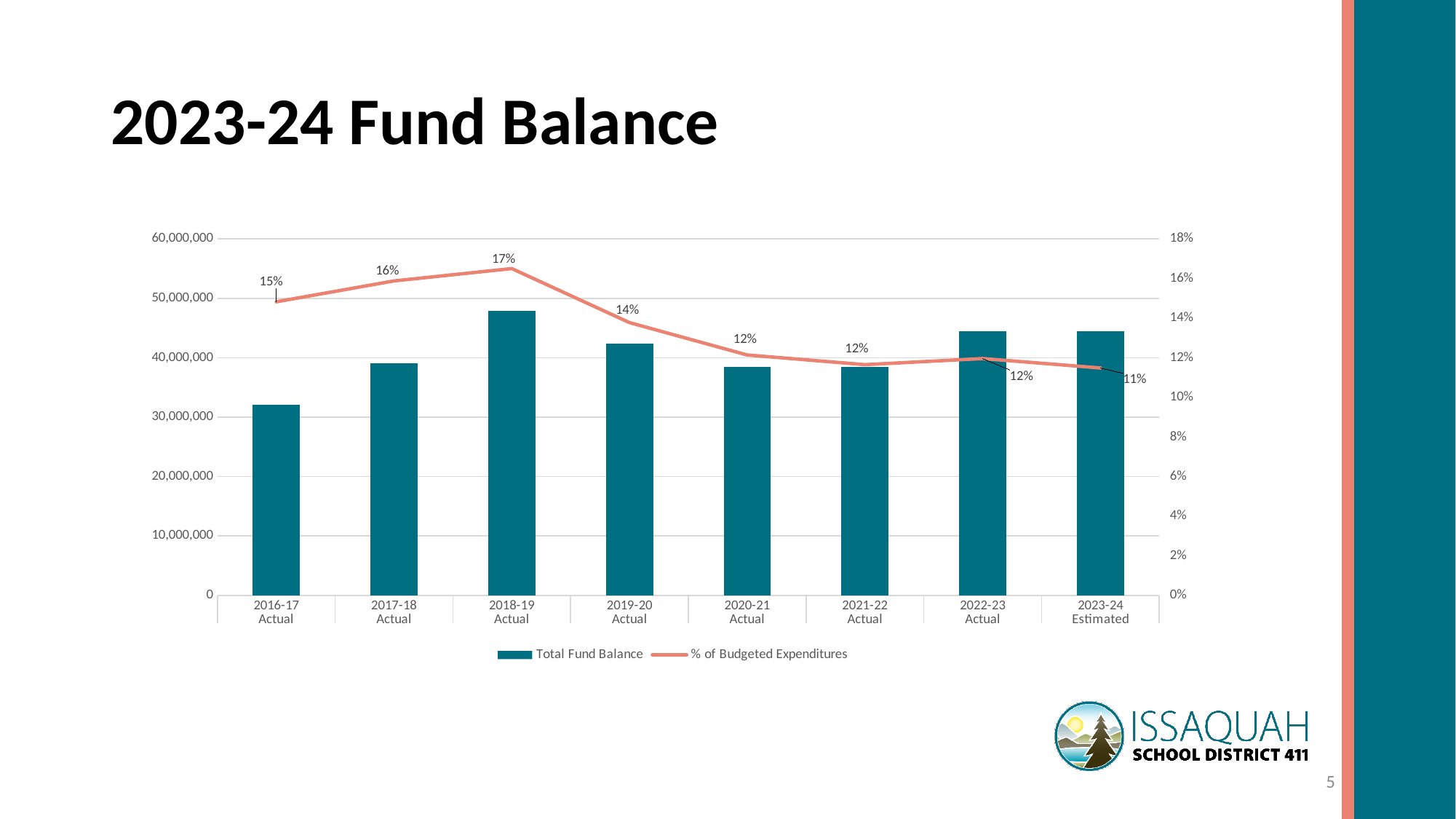
Is the Total Fund Balance for 2019-20 Actual greater or less than 40,000,000? greater Which year has the lowest % of Budgeted Expenditures? 2023-24 Estimated What is the % of Budgeted Expenditures for 2023-24 Estimated? 11% What is the difference in % of Budgeted Expenditures between 2018-19 Actual and 2023-24 Estimated? 6% Is the Total Fund Balance for 2016-17 Actual greater or less than 40,000,000? less Which has a higher % of Budgeted Expenditures, 2017-18 Actual or 2019-20 Actual? 2017-18 Actual What is the % of Budgeted Expenditures for 2016-17 Actual? 15% How many series does the chart legend list? 2 What is the % of Budgeted Expenditures for 2018-19 Actual? 17% How many years are shown on the x axis of the chart? 8 Which year has the highest Total Fund Balance? 2018-19 Actual Which year has the lowest Total Fund Balance? 2016-17 Actual